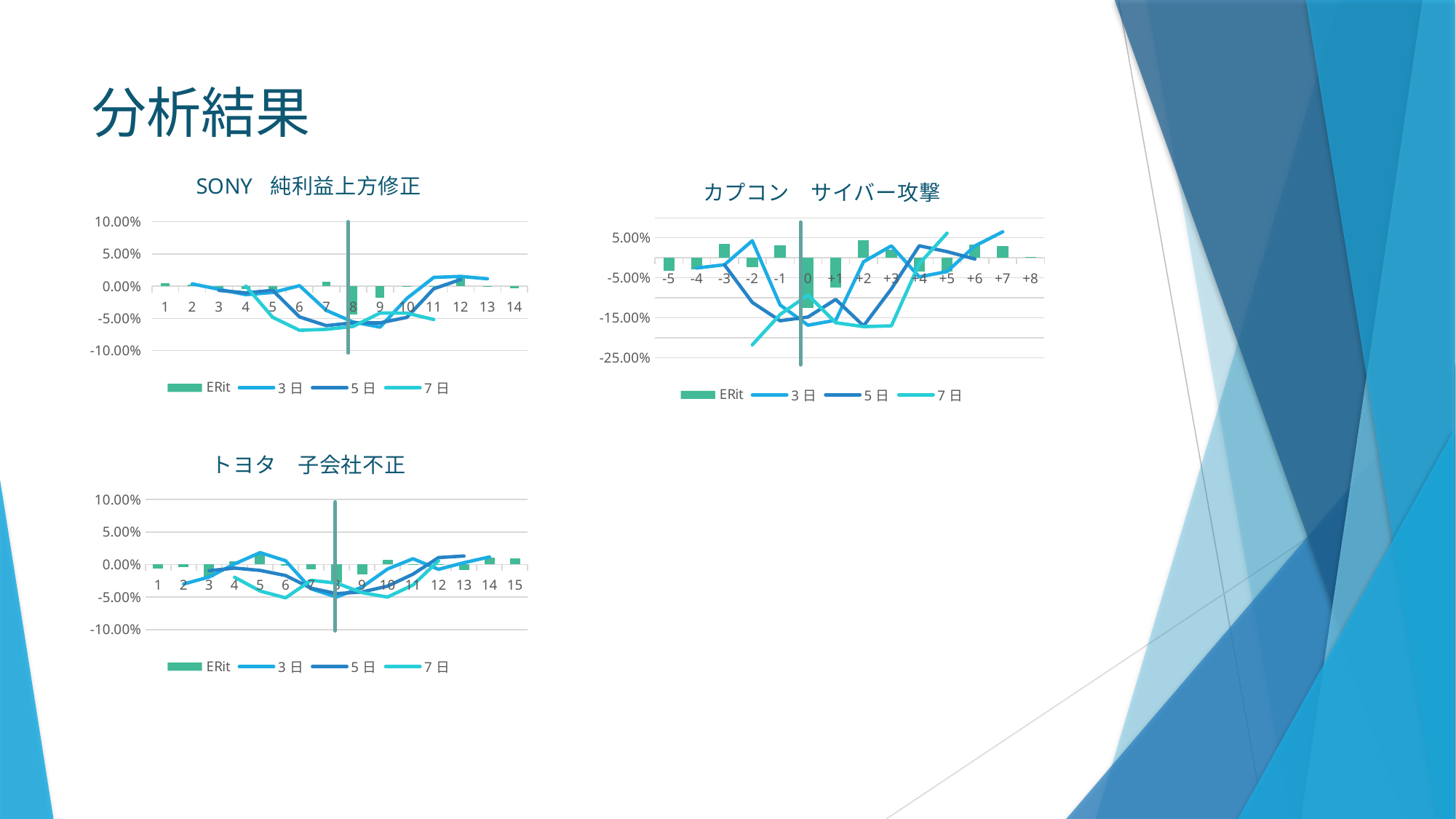
How many series does the legend of the SONY 純利益上方修正 chart list? 4 What is the title of the chart in the top right of the slide? カプコン サイバー攻撃 In the SONY 純利益上方修正 chart, is the 7 日 value at 6 greater or less than -5.00%? less In the カプコン サイバー攻撃 chart, is the ERit value at 0 greater or less than -5.00%? less What kind of chart is the カプコン サイバー攻撃 chart? Combination bar and line chart How many categories are on the x axis of the トヨタ 子会社不正 chart? 15 How many categories are on the x axis of the SONY 純利益上方修正 chart? 14 In the トヨタ 子会社不正 chart, at which x-axis category is the ERit bar lowest? 8 In the カプコン サイバー攻撃 chart, at which x-axis category is the ERit bar lowest? 0 In the カプコン サイバー攻撃 chart, is the 7 日 value at -2 greater or less than -15.00%? less Which series is shown as bars in the トヨタ 子会社不正 chart? ERit